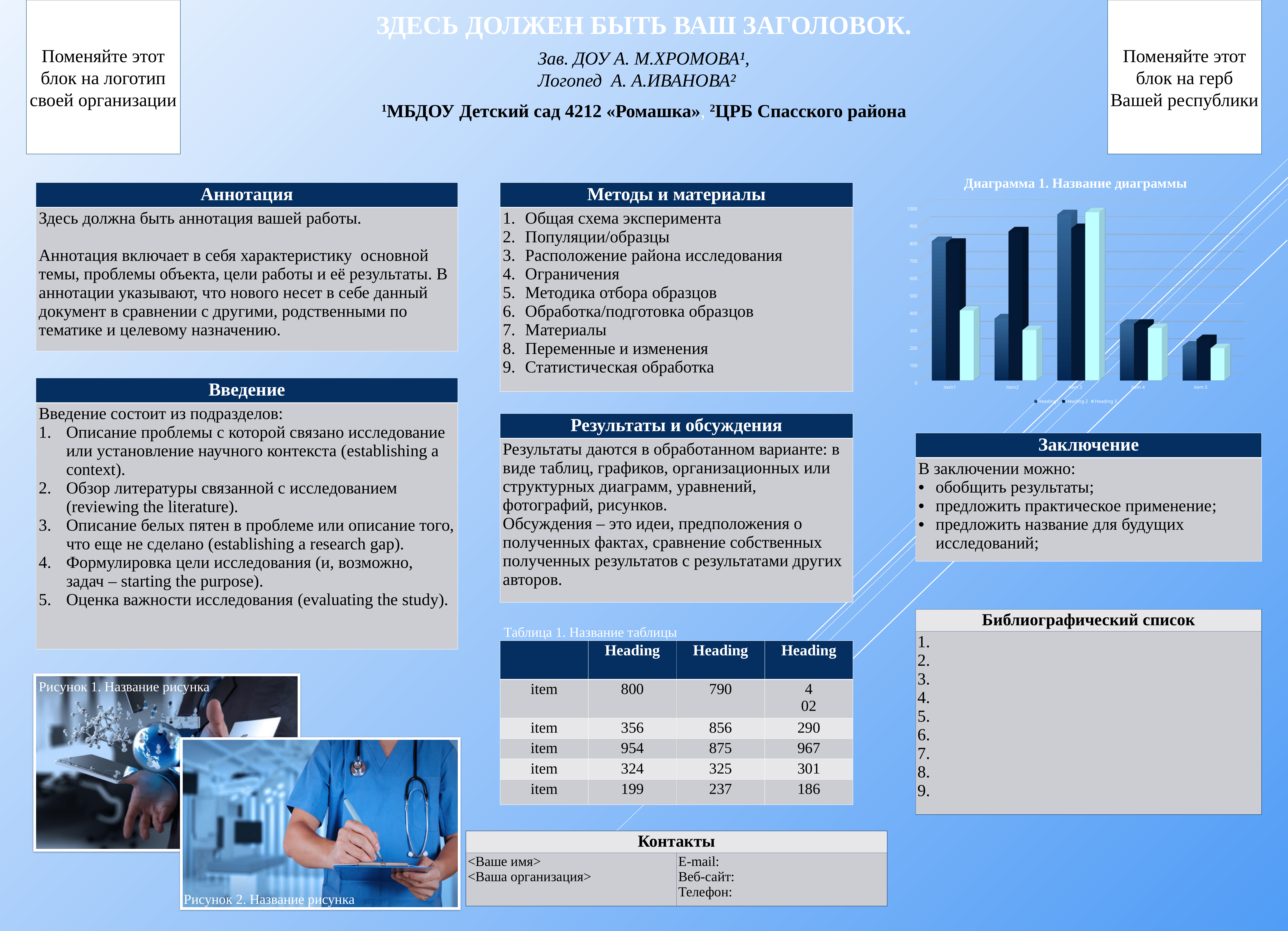
Which category has the highest Heading 1 value in the chart? item 3 What is the title of the chart on the slide? Диаграмма 1. Название диаграммы Is the Heading 1 value for item 3 greater or less than 800? greater Is the Heading 1 value for item 5 greater or less than 300? less Which is larger in the chart: the Heading 1 value for item1 or for item2? item1 Which category has the lowest Heading 1 value in the chart? item 5 How many categories are shown on the x axis of the chart? 5 How many series does the chart's legend list? 3 Is the Heading 2 value for item2 greater or less than 700? greater What kind of chart is shown under the title "Диаграмма 1. Название диаграммы"? bar chart Do the Heading 1 values rise or fall from item 3 to item 5 in the chart? fall What are the series names listed in the chart's legend? Heading1, Heading 2, Heading 3